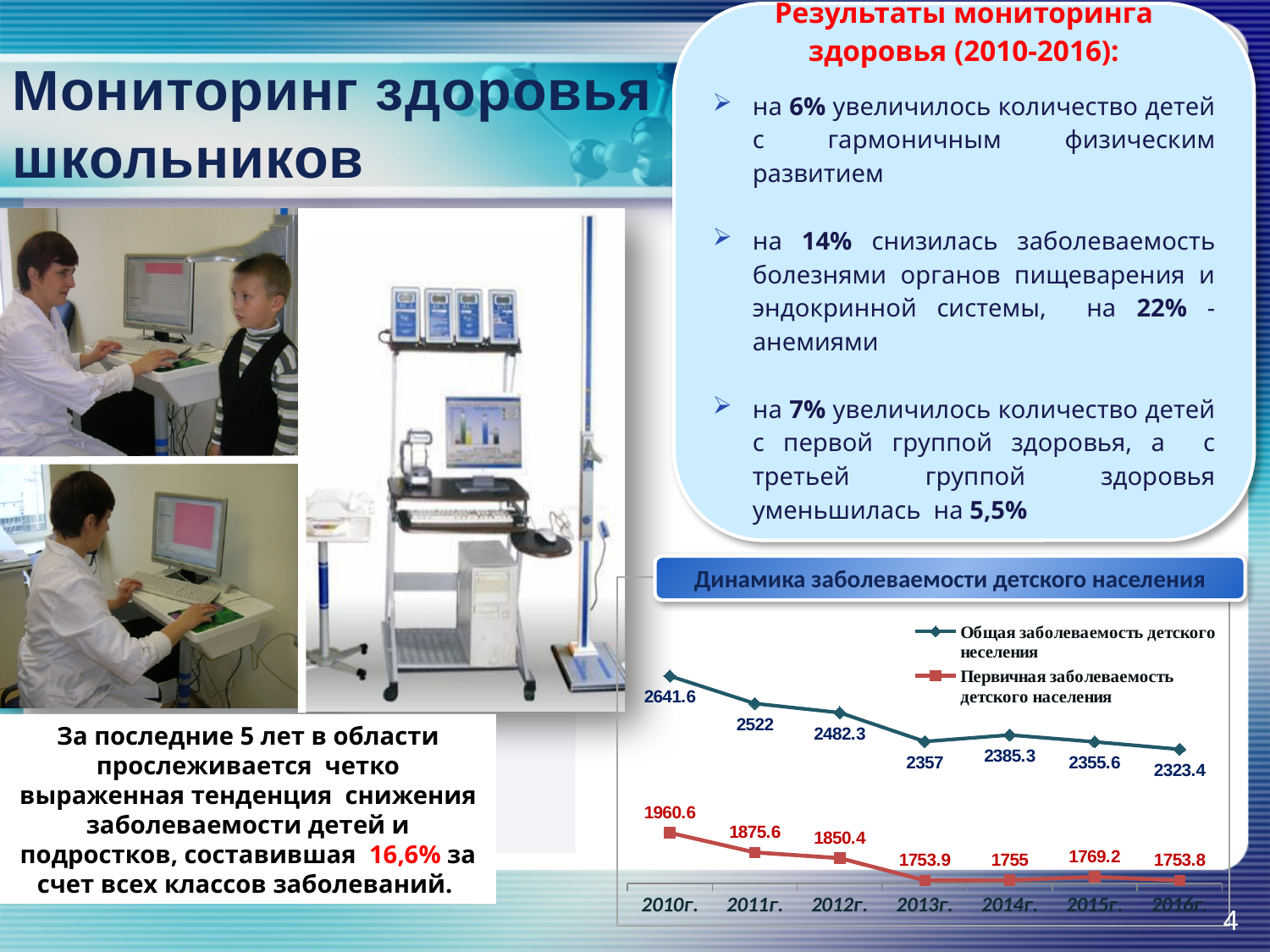
In which year is "Общая заболеваемость детского населения" lowest? 2016г. In which year is "Общая заболеваемость детского населения" highest? 2010г. How many years are shown on the x axis of the chart "Динамика заболеваемости детского населения"? 7 What type of chart is shown under the title "Динамика заболеваемости детского населения"? line chart What is the difference between "Общая заболеваемость детского населения" in 2010г. and in 2016г.? 318.2 Does "Первичная заболеваемость детского населения" generally rise or fall from 2010г. to 2016г.? fall How many series does the legend of the chart "Динамика заболеваемости детского населения" list? 2 In which year is "Первичная заболеваемость детского населения" highest? 2010г. Which is larger in 2013г.: "Общая заболеваемость детского населения" or "Первичная заболеваемость детского населения"? Общая заболеваемость детского населения What is the value of "Общая заболеваемость детского населения" for 2014г.? 2385.3 What is the value of "Общая заболеваемость детского населения" for 2010г.? 2641.6 What is the value of "Первичная заболеваемость детского населения" for 2016г.? 1753.8